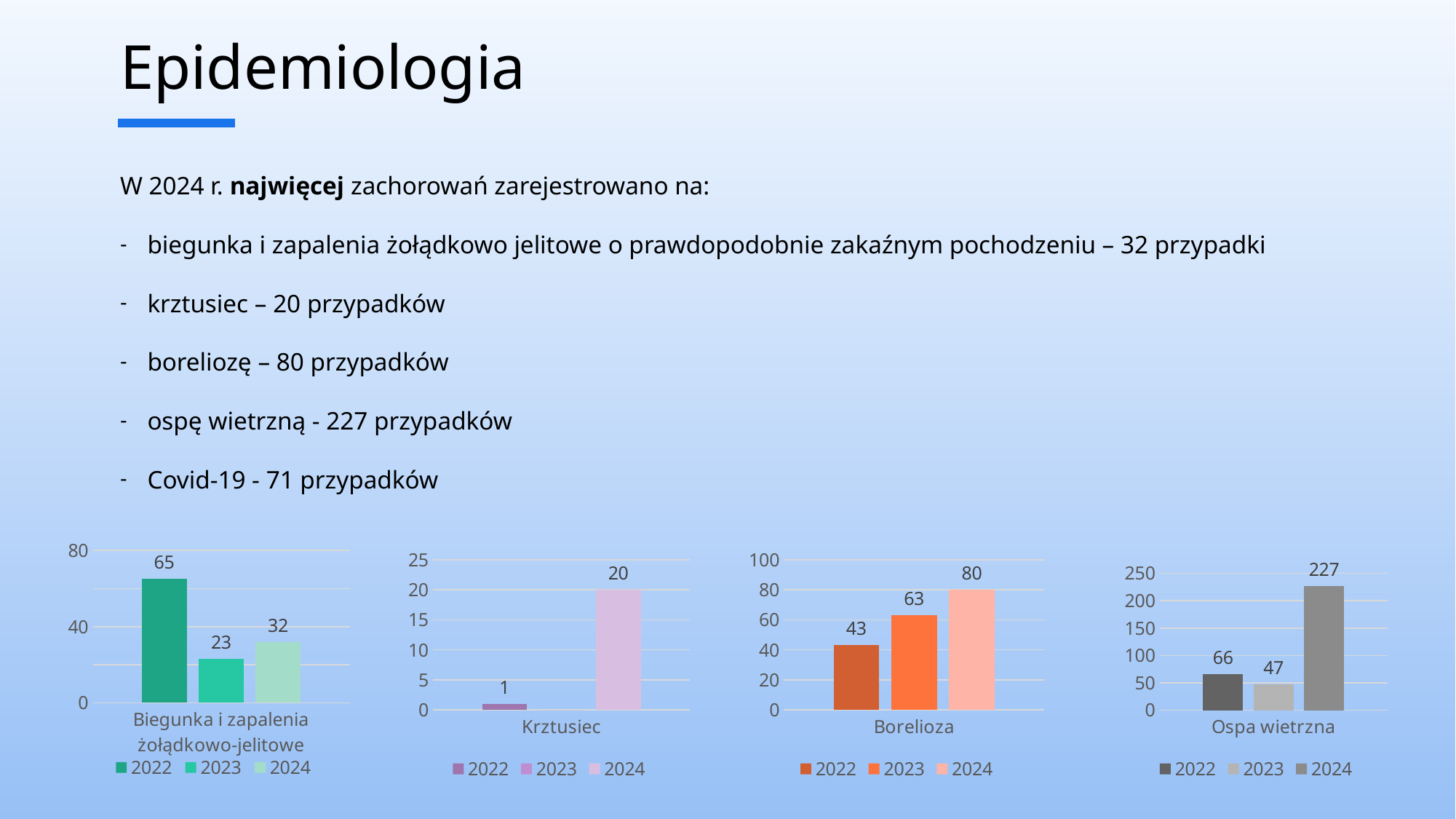
In the Krztusiec chart, what is the value for 2024? 20 In the Biegunka i zapalenia żołądkowo-jelitowe chart, what is the value for 2022? 65 In the Ospa wietrzna chart, what is the value for 2024? 227 In the Biegunka i zapalenia żołądkowo-jelitowe chart, what is the difference between the 2022 and 2024 values? 33 In the Borelioza chart, which year has the highest value? 2024 How many series does the legend of the Borelioza chart list? 3 In the Borelioza chart, what is the value for 2023? 63 In the Borelioza chart, do the values rise or fall from 2022 to 2024? rise In the Krztusiec chart, what is the value for 2022? 1 In the Ospa wietrzna chart, what is the difference between the 2024 and 2023 values? 180 In the Ospa wietrzna chart, which is larger, the value for 2022 or 2023? 2022 In the Biegunka i zapalenia żołądkowo-jelitowe chart, which year has the lowest value? 2023